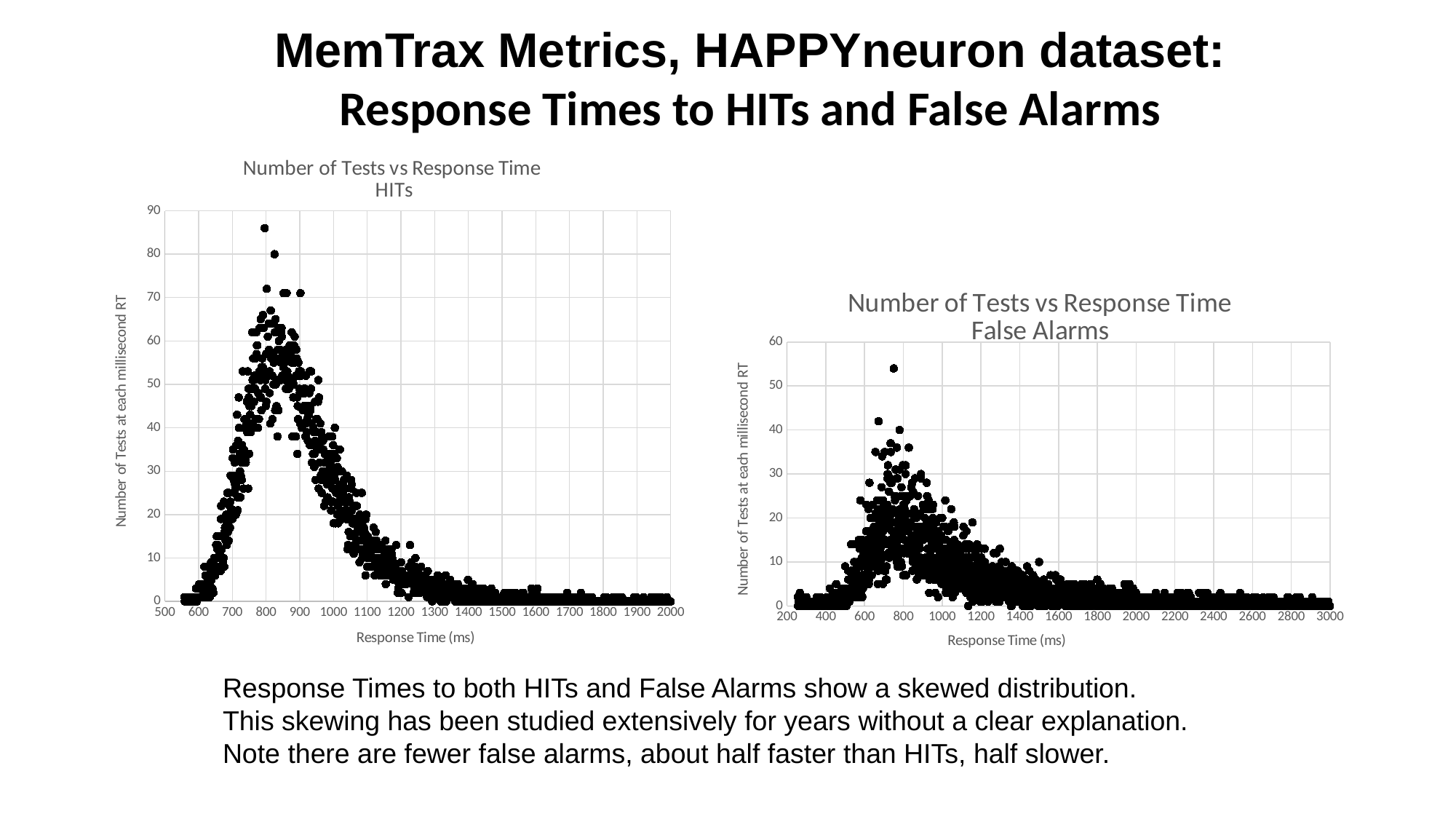
What kind of chart is the 'Number of Tests vs Response Time False Alarms' chart on the right? Scatter chart In the False Alarms chart on the right, is the highest plotted point greater or less than 60? less What is the title of the chart on the right? Number of Tests vs Response Time False Alarms What kind of chart is the 'Number of Tests vs Response Time HITs' chart on the left? Scatter chart In the HITs chart on the left, is the highest plotted point greater or less than 90? less Which chart reaches a higher peak number of tests, the HITs chart or the False Alarms chart? HITs chart What is the x-axis label of the HITs chart on the left? Response Time (ms) In the False Alarms chart on the right, is the highest plotted point greater or less than 50? greater In the HITs chart on the left, do the values rise or fall as response time increases from 1000 ms to 2000 ms? fall In the False Alarms chart on the right, do the values rise or fall as response time increases from 1000 ms to 3000 ms? fall